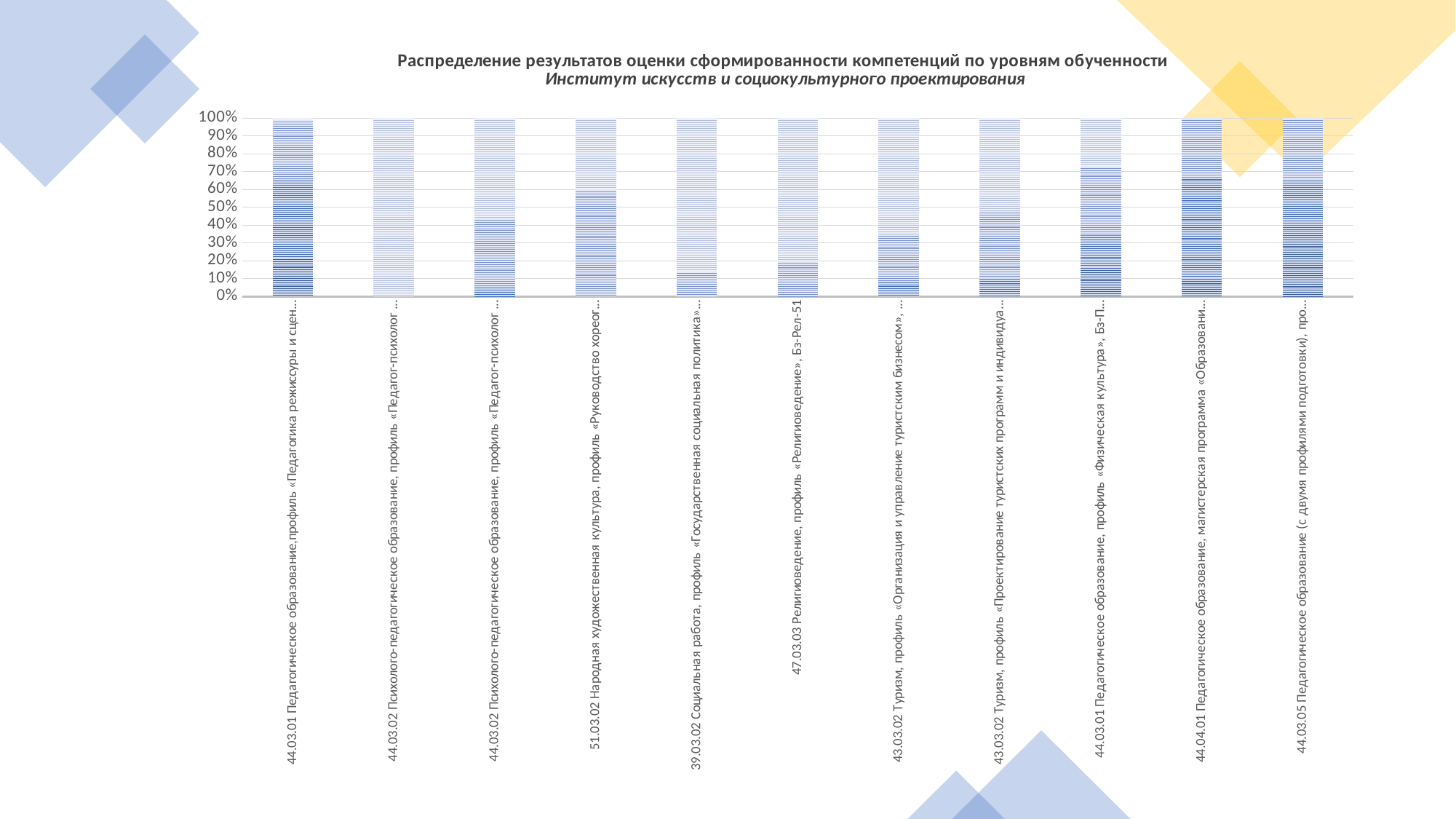
What kind of chart is shown on the slide? Stacked bar chart Which institute is named in the chart's subtitle? Институт искусств и социокультурного проектирования What is the total height of the stacked bar for 47.03.03 Религиоведение, профиль «Религиоведение», Бз-Рел-51? 100% How many categories (bars) are plotted on the chart? 11 What is the title of the chart? Распределение результатов оценки сформированности компетенций по уровням обученности